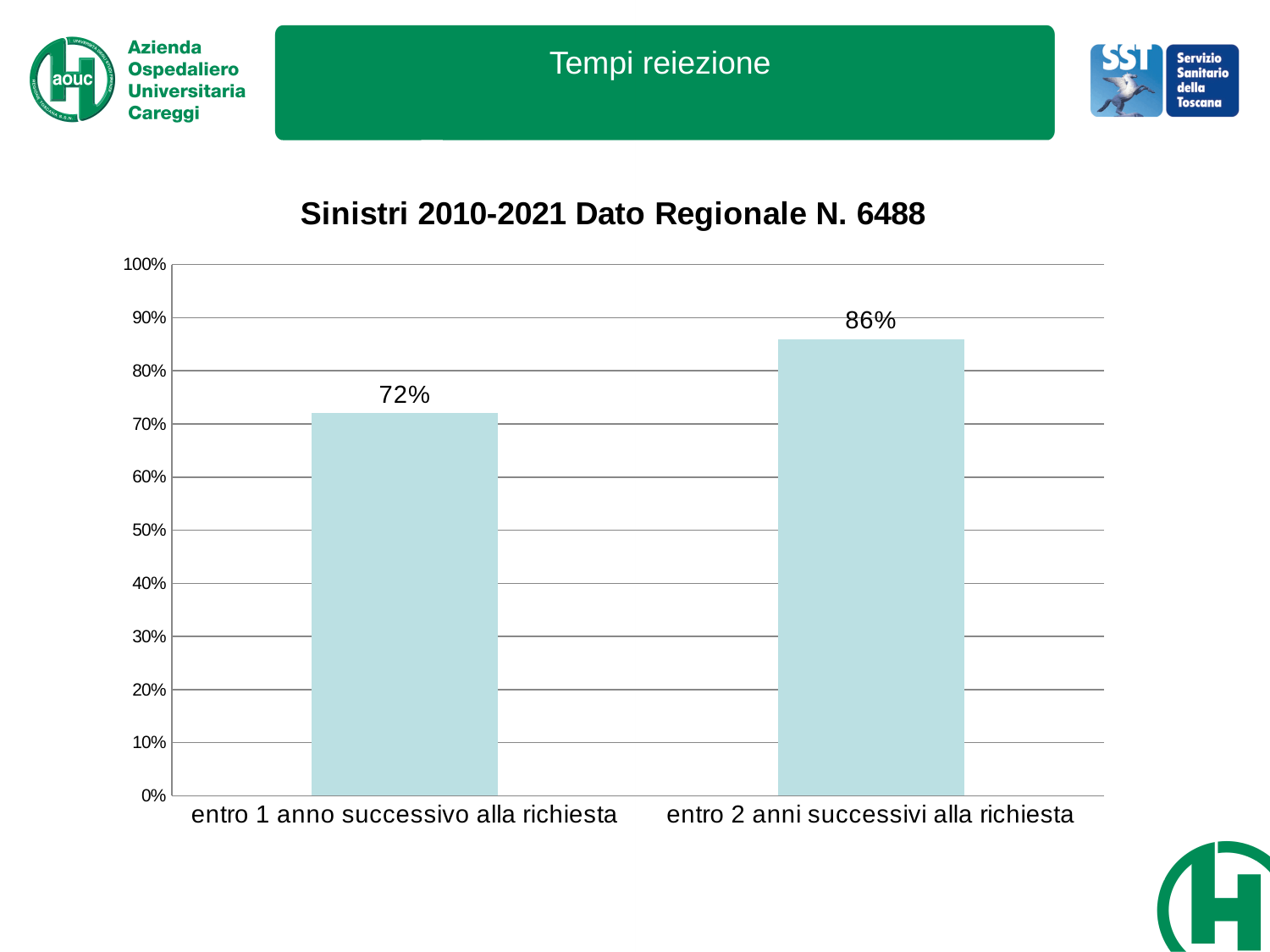
Which category has the highest value? entro 2 anni successivi alla richiesta What is the value for "entro 1 anno successivo alla richiesta"? 72% Which category has the lowest value? entro 1 anno successivo alla richiesta Do the values rise or fall from left to right along the x axis? rise What is the value for "entro 2 anni successivi alla richiesta"? 86% Is the value for "entro 1 anno successivo alla richiesta" greater or less than 80%? less Which is larger: the value for "entro 1 anno successivo alla richiesta" or the value for "entro 2 anni successivi alla richiesta"? entro 2 anni successivi alla richiesta What is the difference between the value for "entro 2 anni successivi alla richiesta" and the value for "entro 1 anno successivo alla richiesta"? 14% What kind of chart is shown on the slide? bar chart How many categories are shown on the x axis? 2 What is the title of the chart? Sinistri 2010-2021 Dato Regionale N. 6488 Is the value for "entro 2 anni successivi alla richiesta" greater or less than 80%? greater